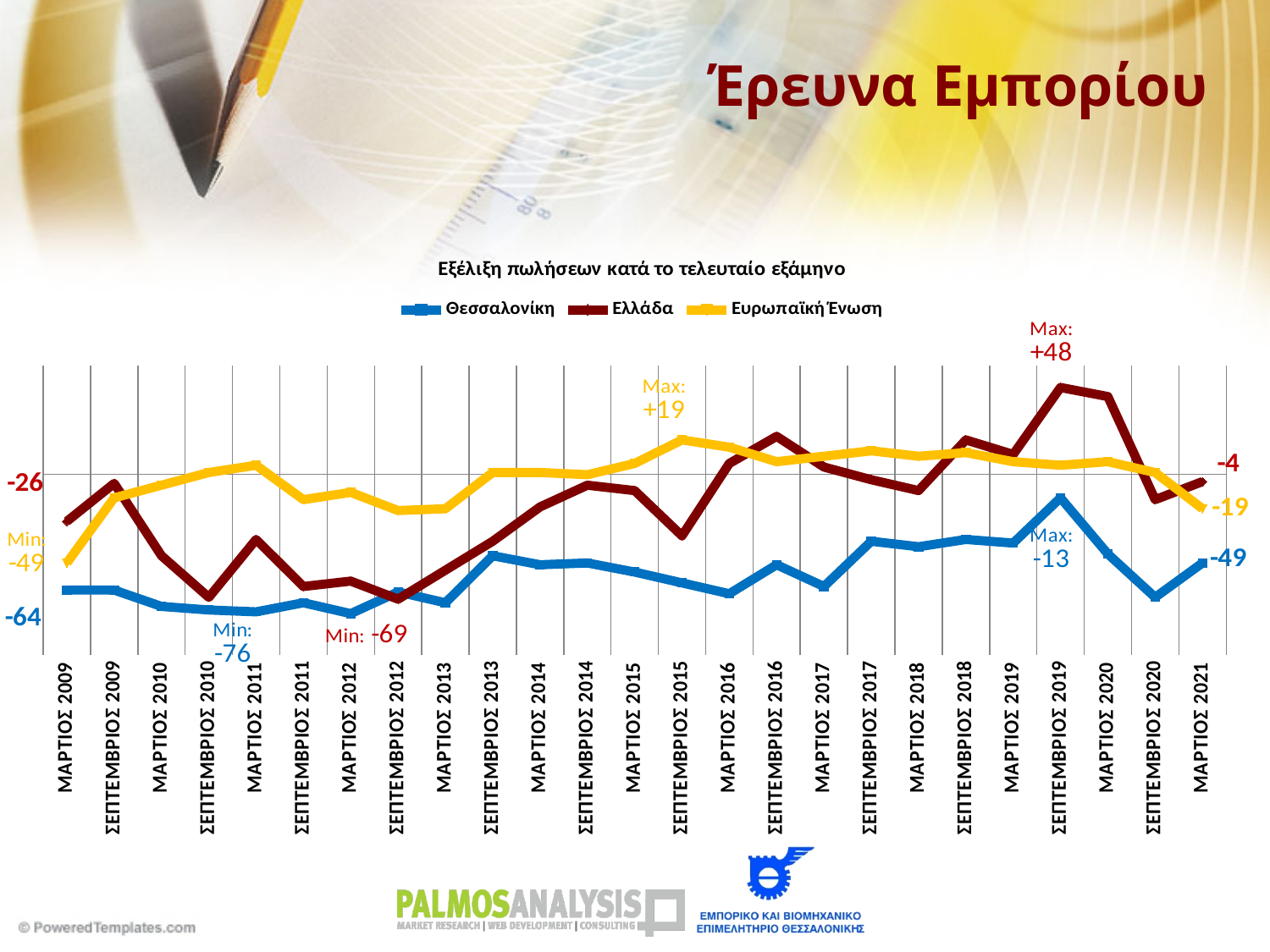
What is the value for Ελλάδα at ΜΑΡΤΙΟΣ 2021? -4 What is the maximum value labelled for the Ελλάδα series? +48 Which series is drawn in yellow? Ευρωπαϊκή Ένωση What is the minimum value labelled for the Θεσσαλονίκη series? -76 How many series does the legend list? 3 What is the title of the chart? Εξέλιξη πωλήσεων κατά το τελευταίο εξάμηνο What is the value for Ευρωπαϊκή Ένωση at ΜΑΡΤΙΟΣ 2021? -19 What is the difference between the labelled maximum of Ελλάδα (+48) and the labelled maximum of Ευρωπαϊκή Ένωση (+19)? 29 How many time points are plotted along the x axis? 25 What kind of chart is shown on the slide? Line chart What is the value for Θεσσαλονίκη at ΜΑΡΤΙΟΣ 2009? -64 At ΜΑΡΤΙΟΣ 2021, which series has the higher value, Ελλάδα or Θεσσαλονίκη? Ελλάδα